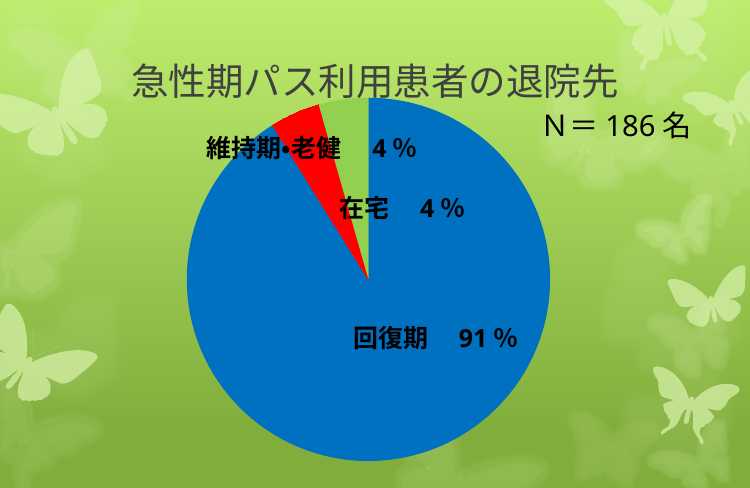
What is the difference in percentage points between 回復期 and 在宅? 87 What share of the pie does 在宅 represent? 4％ What colour is the 回復期 slice? blue Which is larger, the share for 回復期 or the share for 維持期・老健? 回復期 What is the value of N shown on the slide? 186名 Which category has the largest slice of the pie? 回復期 What is the title of the chart? 急性期パス利用患者の退院先 What kind of chart is shown on the slide? pie chart How many slices does the pie chart have? 3 Is the share for 回復期 greater or less than 50%? greater What share of the pie does 維持期・老健 represent? 4％ What share of the pie does 回復期 represent? 91％